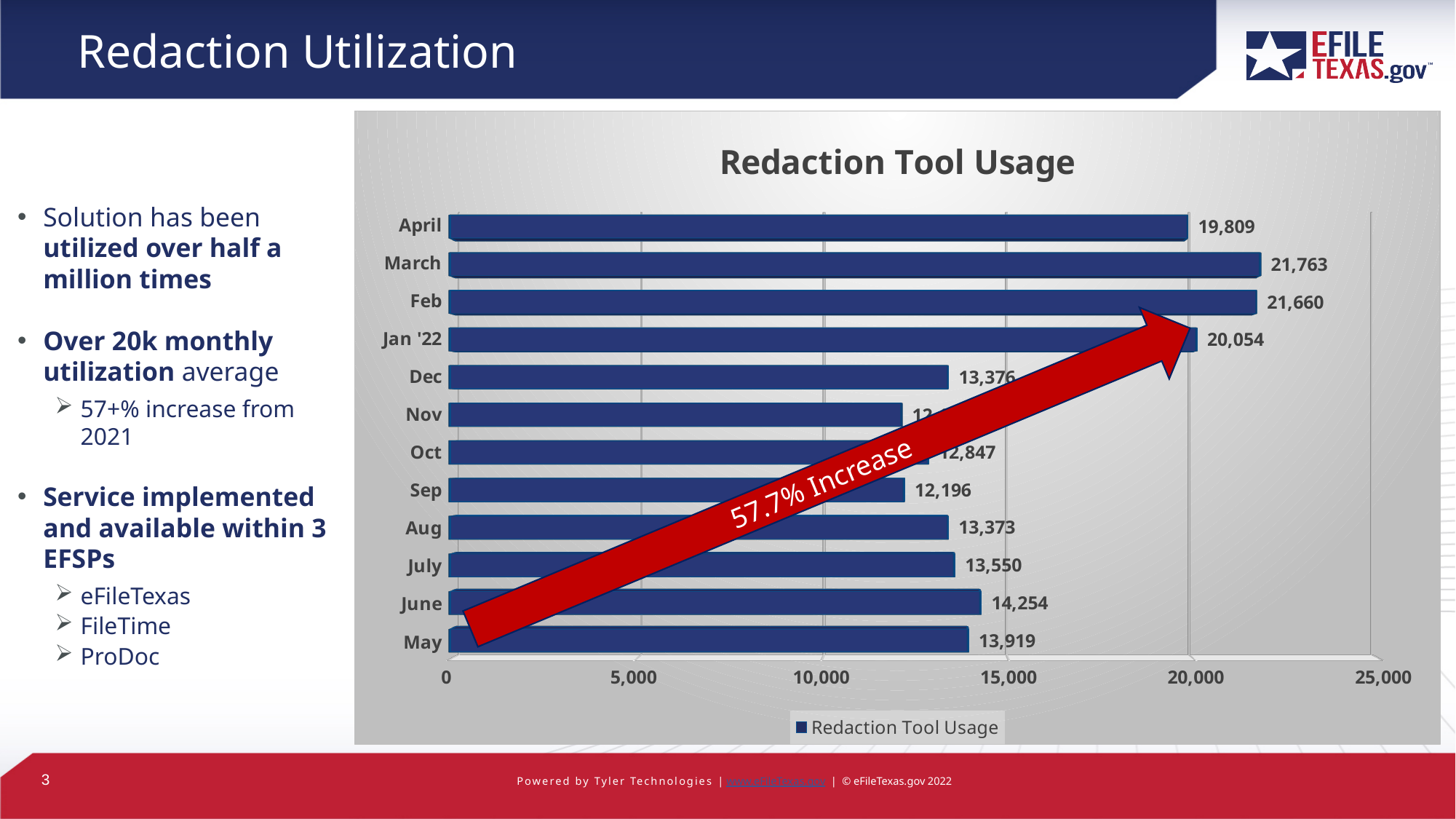
What is the difference between the values for March and Feb in the Redaction Tool Usage chart? 103 Which is larger in the Redaction Tool Usage chart, the value for June or the value for May? June What is the value for Jan '22 in the Redaction Tool Usage chart? 20,054 Is the value for Nov in the Redaction Tool Usage chart greater or less than 15,000? less What is the difference between the values for April and Dec in the Redaction Tool Usage chart? 6,433 What kind of chart is the Redaction Tool Usage chart? bar chart How many months are shown in the Redaction Tool Usage chart? 12 What is the value for April in the Redaction Tool Usage chart? 19,809 Which month has the highest value in the Redaction Tool Usage chart? March What is the value for March in the Redaction Tool Usage chart? 21,763 What is the value for Sep in the Redaction Tool Usage chart? 12,196 How many series does the legend of the Redaction Tool Usage chart list? 1